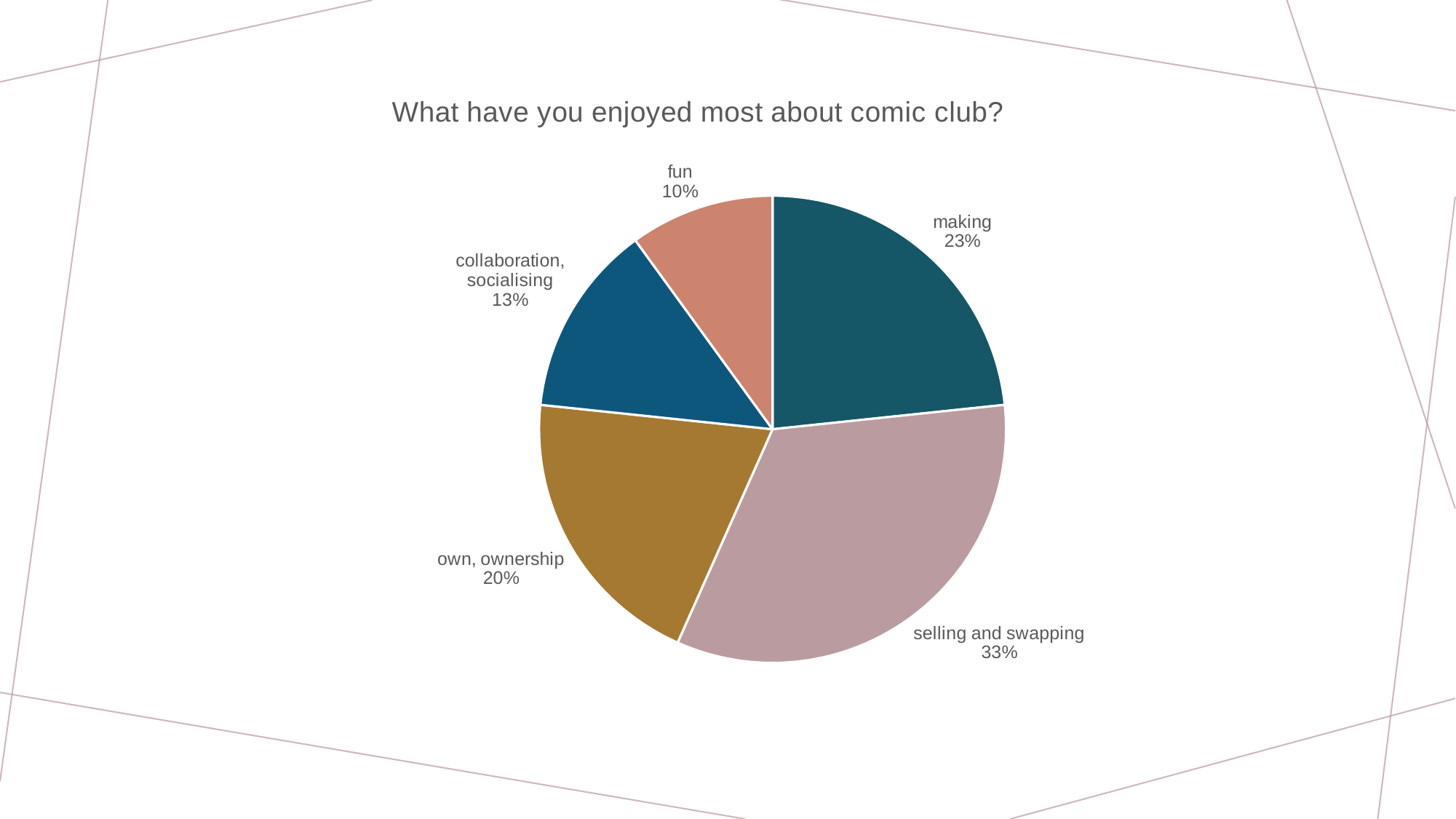
What share of the pie is 'fun'? 10% What is the difference in percentage points between 'selling and swapping' and 'making'? 10 How many slices does the pie chart have? 5 Which category has the largest slice? selling and swapping What share of the pie is 'selling and swapping'? 33% What share of the pie is 'own, ownership'? 20% Which category has the smallest slice? fun What kind of chart is shown on the slide? pie chart Which is larger, 'own, ownership' or 'collaboration, socialising'? own, ownership What is the title of the chart? What have you enjoyed most about comic club?